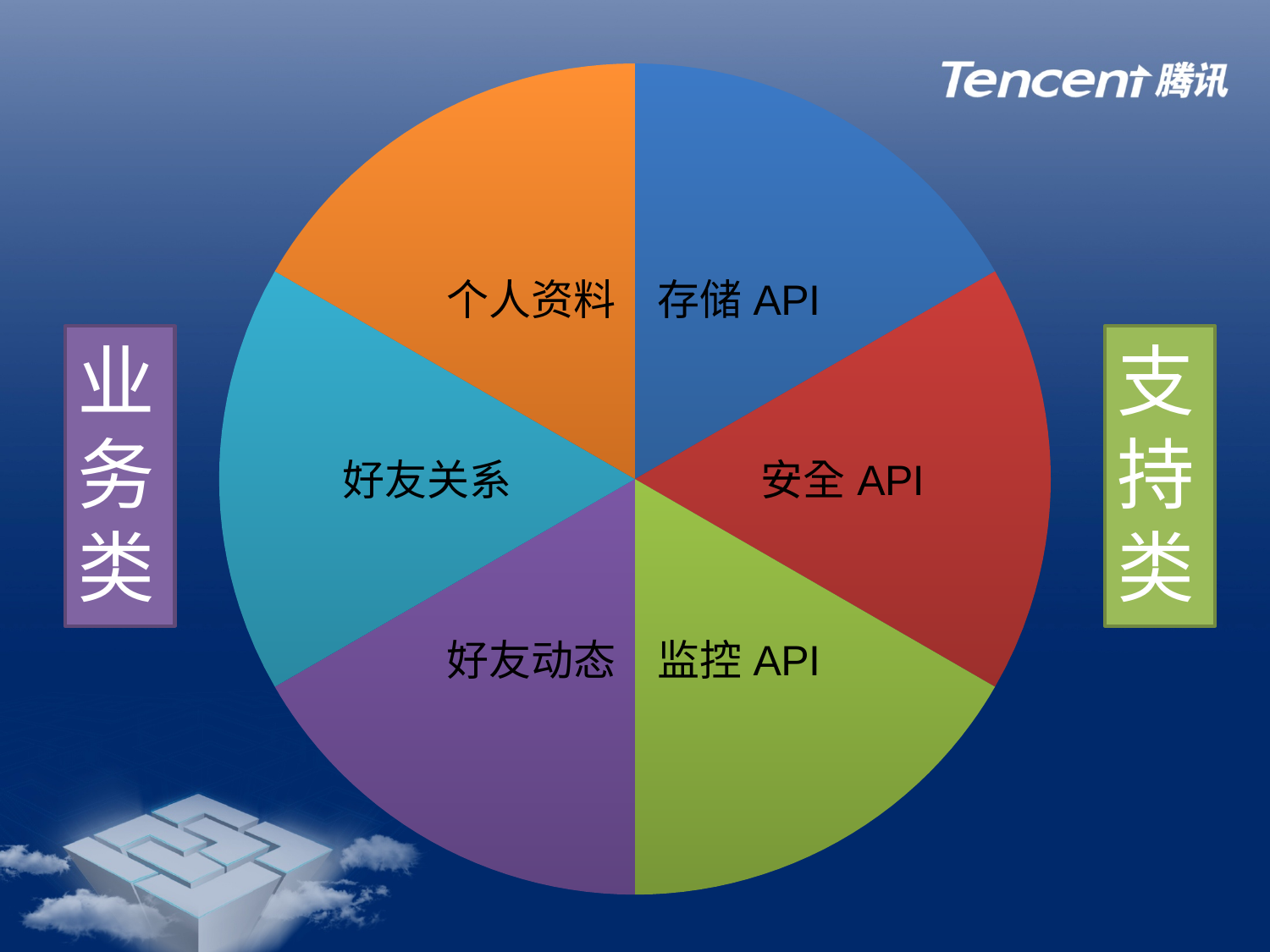
What kind of chart is shown on the slide? pie chart Which group label is shown in the box to the left of the pie chart? 业务类 How many slices does the pie chart have? 6 What colour is the slice labelled 存储 API? blue How many slices of the pie chart have labels containing 'API'? 3 Which slice of the pie chart is coloured orange? 个人资料 Which category label appears in the red slice of the pie chart? 安全 API Which category label appears in the purple slice of the pie chart? 好友动态 Which group label is shown in the box to the right of the pie chart? 支持类 Which category label appears in the teal (light blue) slice of the pie chart? 好友关系 Which category label appears in the green slice of the pie chart? 监控 API